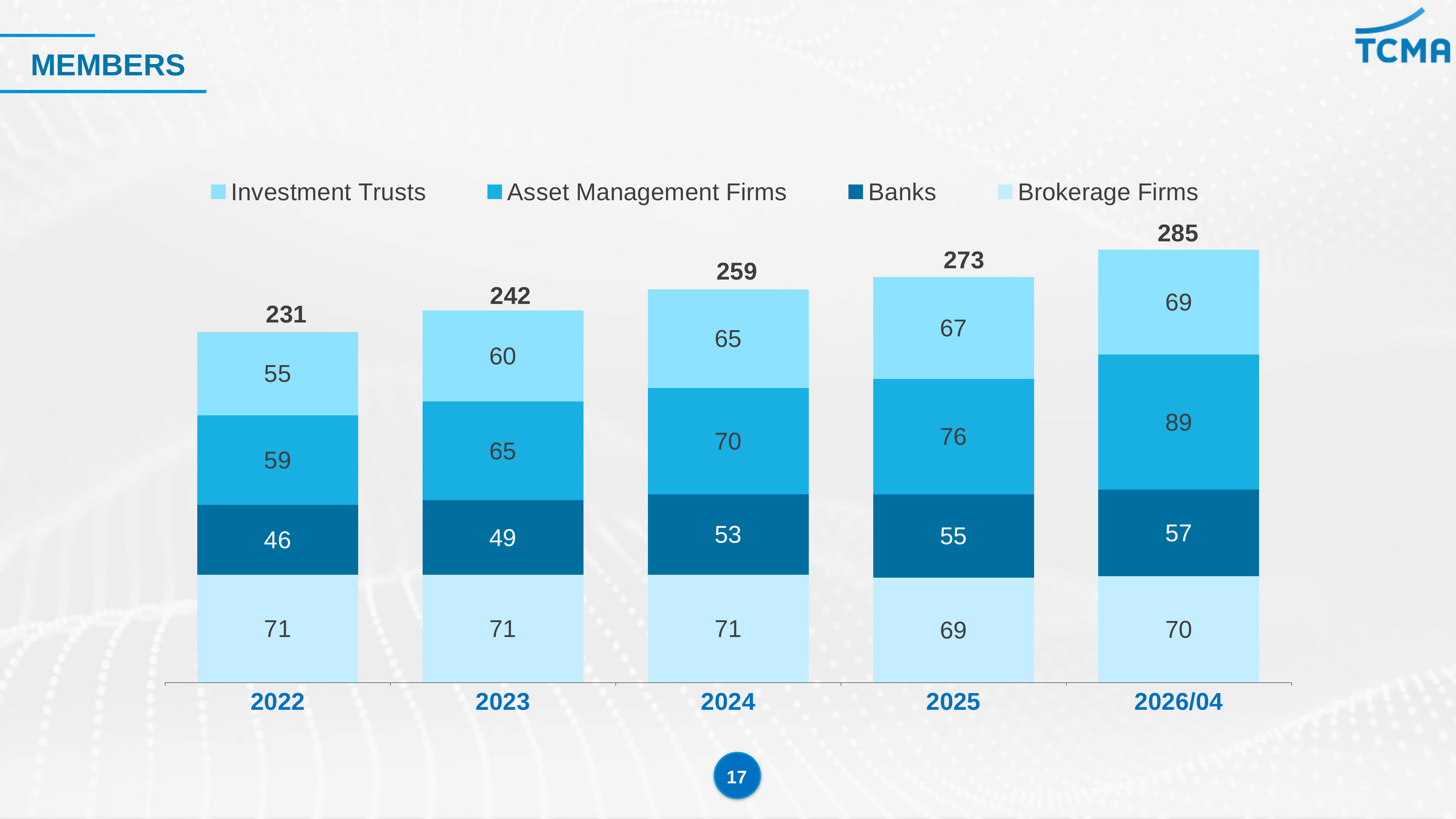
What type of chart is shown on the slide? stacked bar chart In which year is the total number of members highest? 2026/04 Do the total members rise or fall from 2022 to 2026/04? rise What is the value for Banks in 2022? 46 What is the total number of members in 2024? 259 What is the difference between the total members in 2026/04 and in 2022? 54 Which is larger: Asset Management Firms in 2025 or Banks in 2025? Asset Management Firms What is the value for Banks in 2025? 55 How many series does the legend list? 4 In which year is the total number of members lowest? 2022 How many years (categories) are shown on the x axis? 5 What is the value for Asset Management Firms in 2026/04? 89